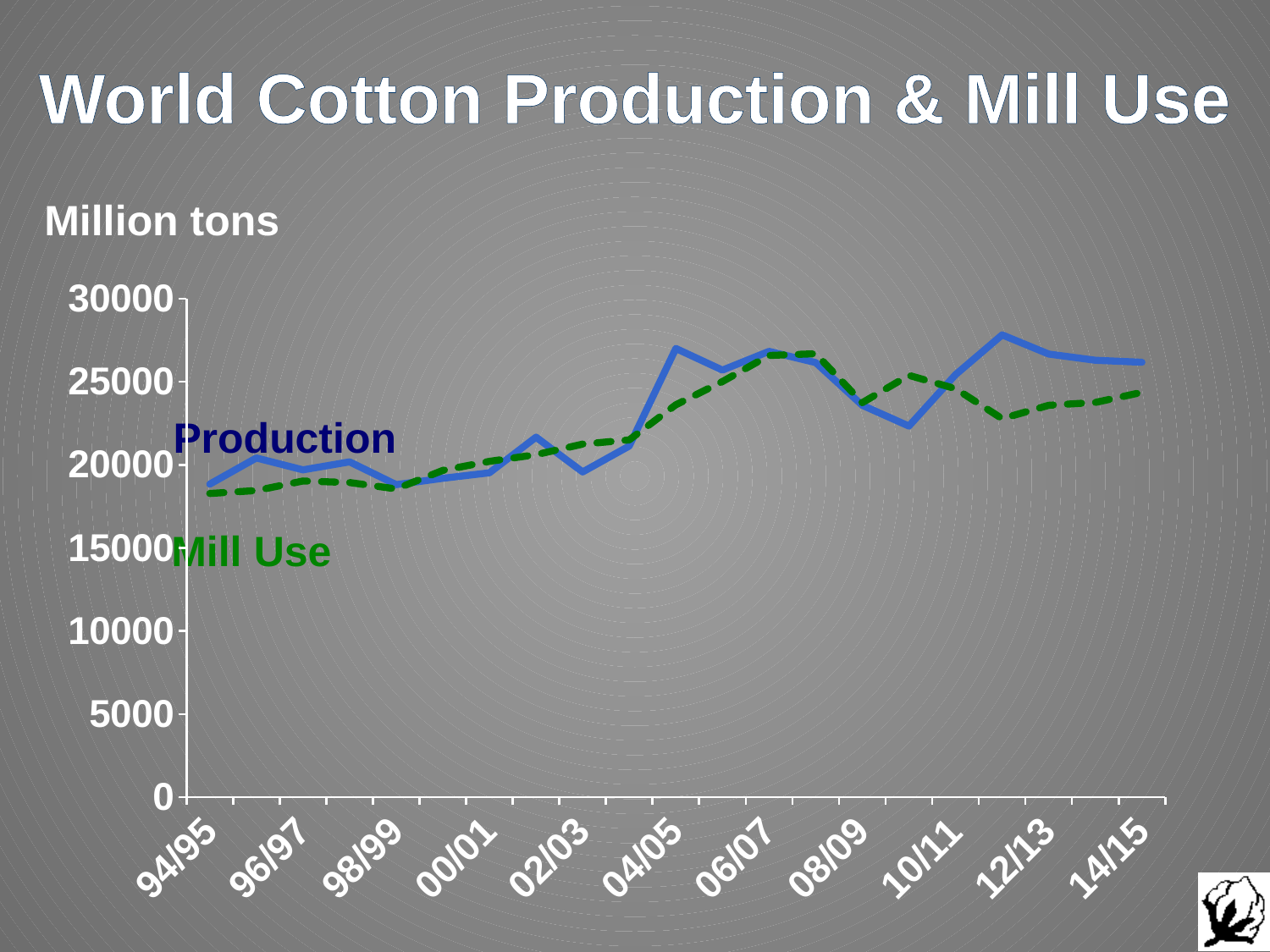
What unit is given for the y axis? Million tons How many year labels are shown on the x axis? 11 Is the value for Mill Use in 06/07 greater or less than 25000? greater Is the value for Mill Use in 94/95 greater or less than 20000? less How many series are plotted on the chart? 2 In 04/05, which series has the higher value, Production or Mill Use? Production What is the title of the chart? World Cotton Production & Mill Use What kind of chart is shown on the slide? line chart Is the value for Production in 94/95 greater or less than 20000? less Does Mill Use generally rise or fall from 94/95 to 06/07? rise In 10/11, which series has the higher value, Production or Mill Use? Production